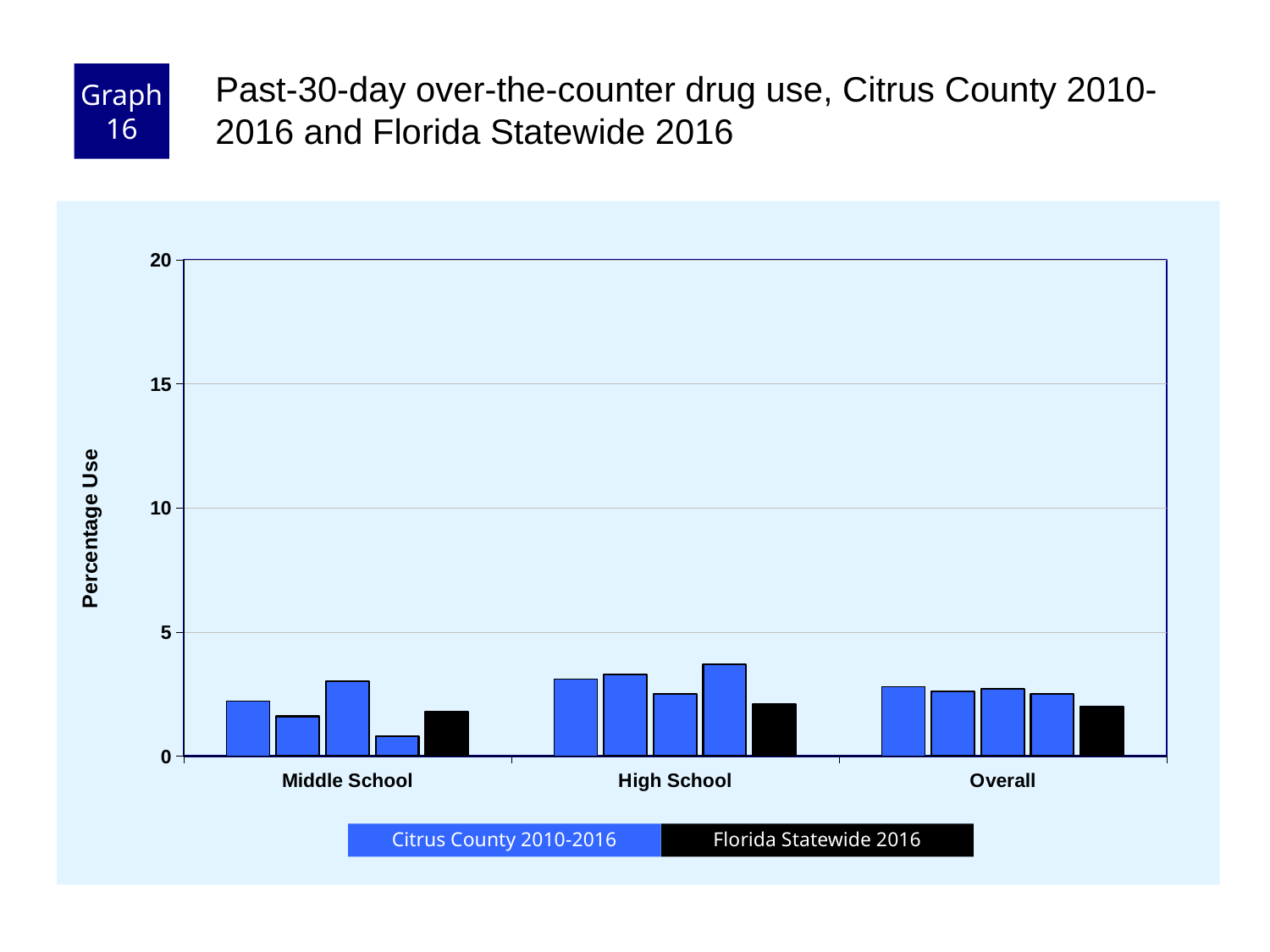
Which category has the lowest single bar on the chart? Middle School Is the Florida Statewide 2016 value for High School greater or less than 5? less What is the label on the y axis? Percentage Use Are any bars on the chart greater than 10? No How many series does the legend list? 2 How many categories are shown on the x axis? 3 Is the Florida Statewide 2016 value for Overall greater or less than 5? less Which category contains the tallest bar on the chart? High School Which series is shown in black? Florida Statewide 2016 What kind of chart is shown on the slide? bar chart For Middle School, which is larger: the fourth Citrus County bar or the Florida Statewide 2016 bar? Florida Statewide 2016